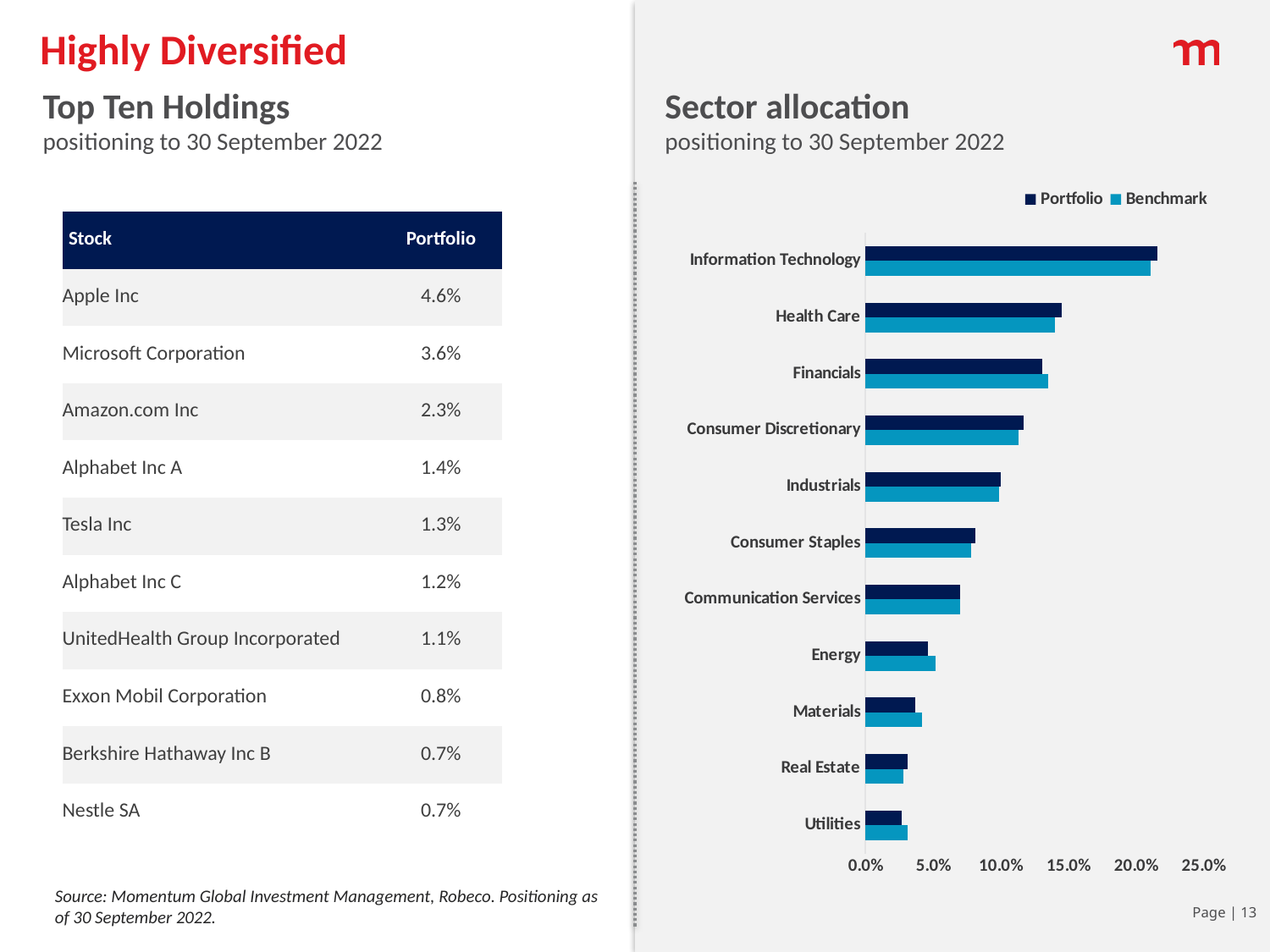
How many series does the legend of the Sector allocation chart list? 2 Which sector has the lowest Portfolio allocation in the Sector allocation chart? Utilities Which sector has a larger Portfolio allocation: Financials or Consumer Staples? Financials Which sector has the highest Portfolio allocation in the Sector allocation chart? Information Technology How many sectors are shown in the Sector allocation chart? 11 Which sector has the highest Benchmark allocation in the Sector allocation chart? Information Technology Is the Portfolio value for Health Care greater or less than 15.0%? less Which two series are shown in the legend of the Sector allocation chart? Portfolio and Benchmark Is the Portfolio value for Utilities greater or less than 5.0%? less Is the Portfolio value for Information Technology greater or less than 20.0%? greater For Energy, which is larger: the Portfolio bar or the Benchmark bar? Benchmark What kind of chart is the Sector allocation chart? bar chart